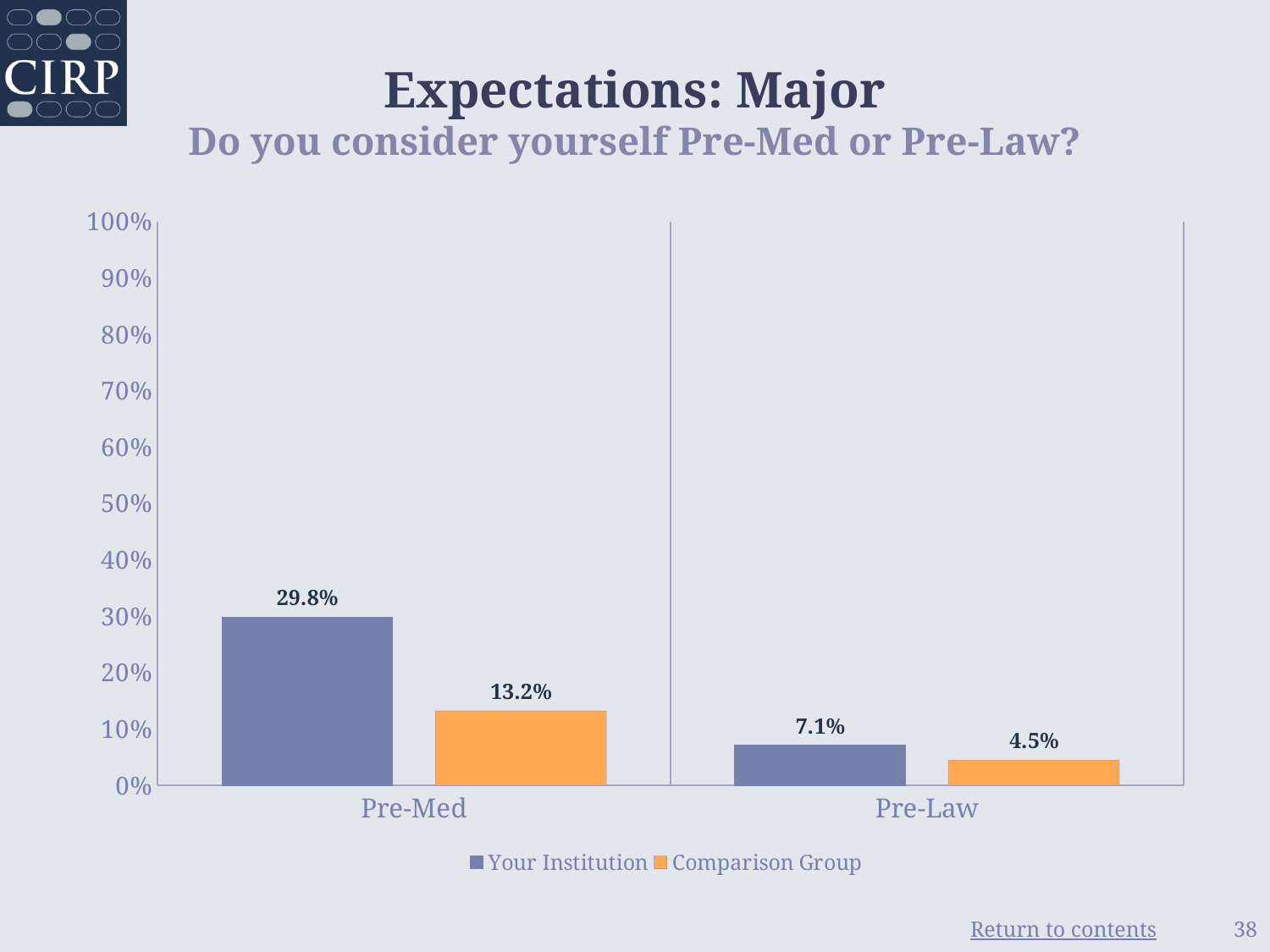
What is the value for Your Institution in the Pre-Law category? 7.1% Which is larger for Pre-Med: Your Institution or Comparison Group? Your Institution What is the value for Comparison Group in the Pre-Law category? 4.5% What is the value for Your Institution in the Pre-Med category? 29.8% Which category has the lowest value for Comparison Group? Pre-Law What is the difference between Your Institution and Comparison Group for Pre-Law? 2.6% Which category has the highest value for Your Institution? Pre-Med How many series does the legend list? 2 How many categories are shown on the x axis? 2 What kind of chart is shown on the slide? bar chart What is the difference between Your Institution and Comparison Group for Pre-Med? 16.6% Is the value for Comparison Group in Pre-Med greater or less than 20%? less